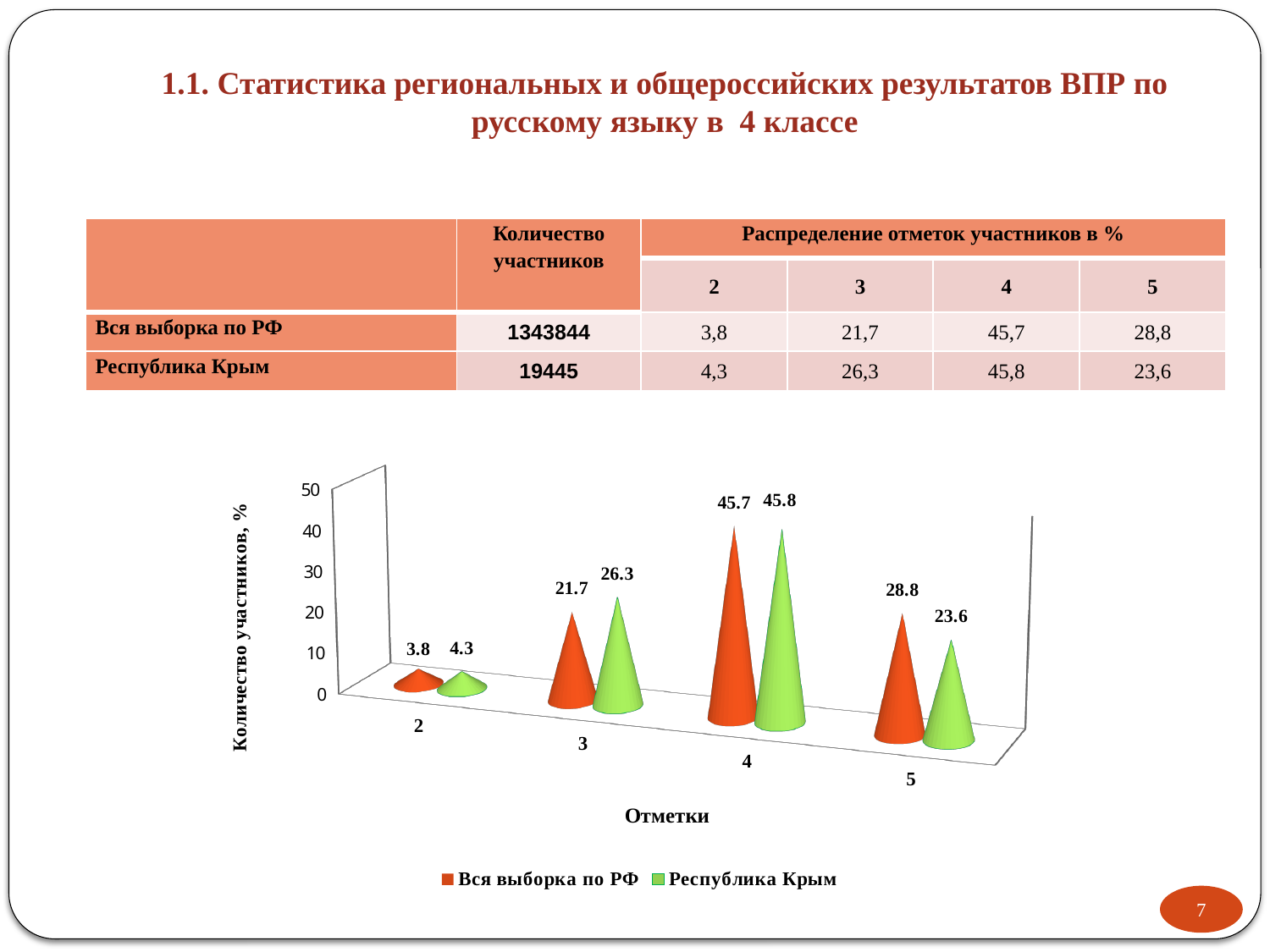
At mark 3, which series has the larger value: Вся выборка по РФ or Республика Крым? Республика Крым What is the value for Республика Крым at mark 3 in the chart? 26.3 What is the label of the vertical axis of the chart? Количество участников, % What is the value for Вся выборка по РФ at mark 2 in the chart? 3.8 Which colour represents Республика Крым in the chart? green How many series does the chart legend list? 2 Which mark has the highest value for Республика Крым in the chart? 4 Which mark has the lowest value for Вся выборка по РФ in the chart? 2 What is the value for Вся выборка по РФ at mark 5 in the chart? 28.8 What kind of chart is shown on the slide? bar chart How many marks (categories) are shown on the x axis of the chart? 4 What is the difference between Вся выборка по РФ and Республика Крым at mark 5 in the chart? 5.2